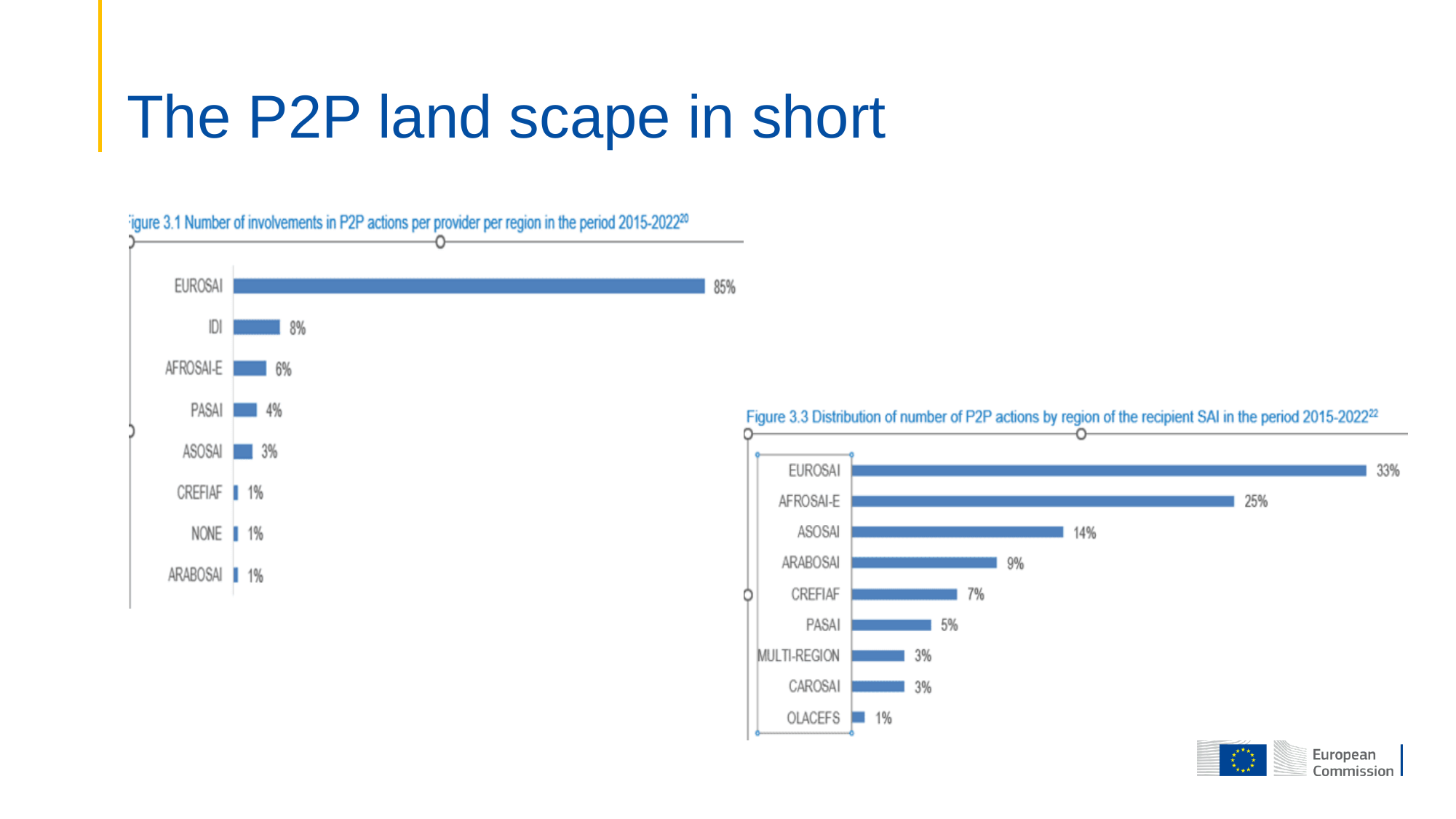
What kind of chart is Figure 3.1 (left chart)? Bar chart In Figure 3.3 (right chart), what is the value for CREFIAF? 7% In Figure 3.3 (right chart), how many categories are shown? 9 In Figure 3.1 (left chart), what is the difference between the values for IDI and PASAI? 4% In Figure 3.3 (right chart), what is the difference between the values for EUROSAI and AFROSAI-E? 8% In Figure 3.1 (left chart), what is the value for AFROSAI-E? 6% In Figure 3.3 (right chart), which is larger, the value for ARABOSAI or the value for PASAI? ARABOSAI In Figure 3.1 (left chart), what is the value for EUROSAI? 85% In Figure 3.3 (right chart), what is the value for ASOSAI? 14% In Figure 3.1 (left chart), which category has the highest value? EUROSAI In Figure 3.3 (right chart), which category has the lowest value? OLACEFS In Figure 3.1 (left chart), how many categories are shown? 8